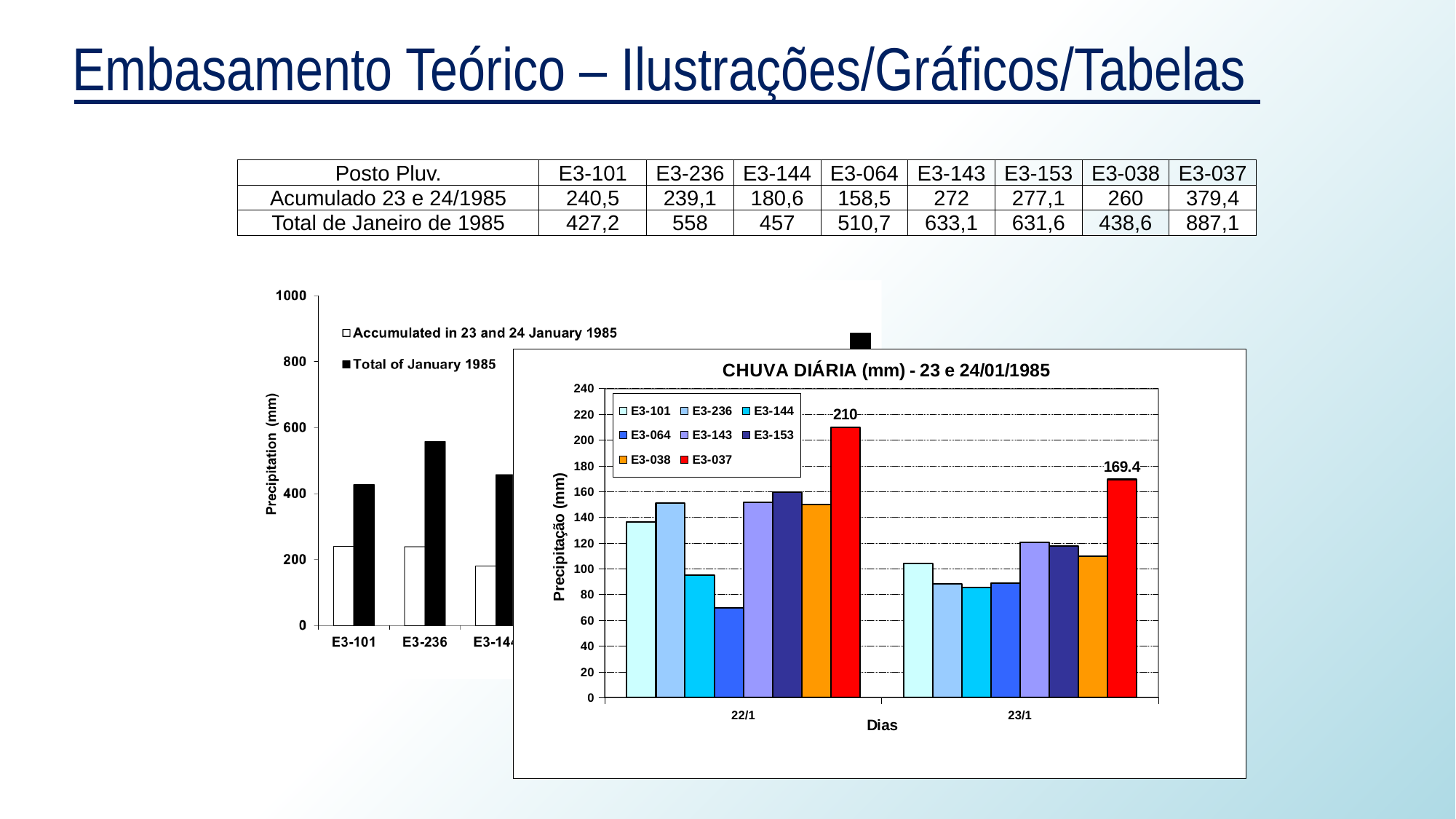
In the chart on the left with the y axis "Precipitation (mm)", how many series does the legend list? 2 In the chart titled "CHUVA DIÁRIA (mm) - 23 e 24/01/1985", how many days are shown on the x axis? 2 In the chart titled "CHUVA DIÁRIA (mm) - 23 e 24/01/1985", is the value for E3-064 on 22/1 greater or less than 80? less In the chart titled "CHUVA DIÁRIA (mm) - 23 e 24/01/1985", which station has the highest value on 22/1? E3-037 In the chart titled "CHUVA DIÁRIA (mm) - 23 e 24/01/1985", how many series does the legend list? 8 In the chart titled "CHUVA DIÁRIA (mm) - 23 e 24/01/1985", what is the difference between the E3-037 values on 22/1 and 23/1? 40.6 In the chart titled "CHUVA DIÁRIA (mm) - 23 e 24/01/1985", what is the value for E3-037 on 22/1? 210 In the chart titled "CHUVA DIÁRIA (mm) - 23 e 24/01/1985", is the value for E3-037 larger on 22/1 or on 23/1? 22/1 In the chart titled "CHUVA DIÁRIA (mm) - 23 e 24/01/1985", is the value for E3-143 on 23/1 greater or less than 100? greater What kind of chart is the one titled "CHUVA DIÁRIA (mm) - 23 e 24/01/1985"? bar chart In the chart titled "CHUVA DIÁRIA (mm) - 23 e 24/01/1985", which station has the lowest value on 22/1? E3-064 In the chart titled "CHUVA DIÁRIA (mm) - 23 e 24/01/1985", what is the value for E3-037 on 23/1? 169.4